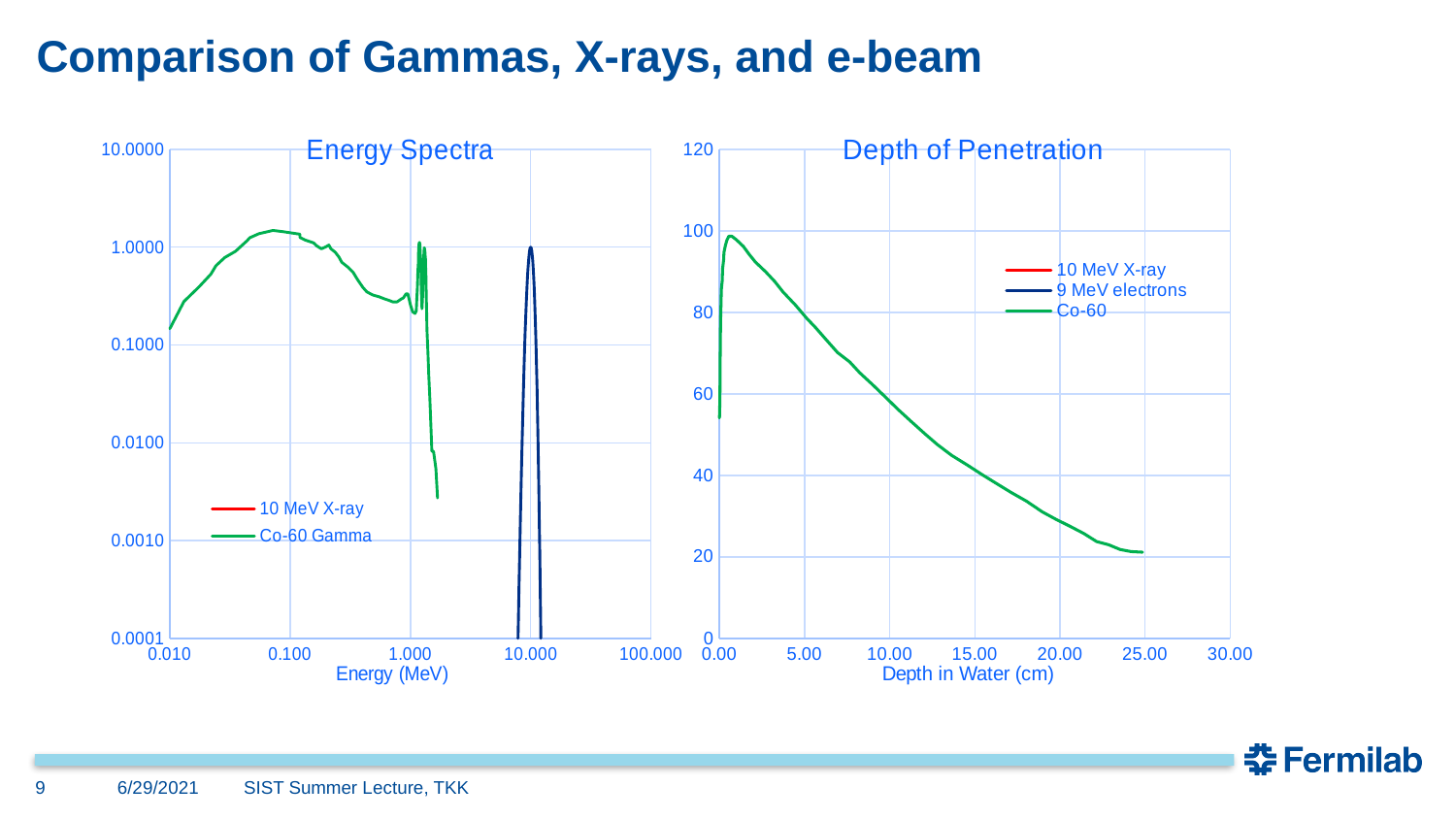
In the Energy Spectra chart, is the Co-60 Gamma value at 0.010 MeV greater or less than 1.0000? less What is the x-axis label of the Depth of Penetration chart? Depth in Water (cm) What kind of chart is the Energy Spectra chart on the left? line chart How many series does the legend of the Depth of Penetration chart list? 3 How many series does the legend of the Energy Spectra chart list? 2 What is the x-axis label of the Energy Spectra chart? Energy (MeV) In the Depth of Penetration chart, is the Co-60 value at a depth of 5.00 cm greater or less than 60? greater What kind of chart is the Depth of Penetration chart on the right? line chart In the Energy Spectra chart, is the peak of the Co-60 Gamma curve greater or less than 1.0000? greater In the Depth of Penetration chart, does the Co-60 curve rise or fall as depth increases from 5.00 cm to 25.00 cm? fall